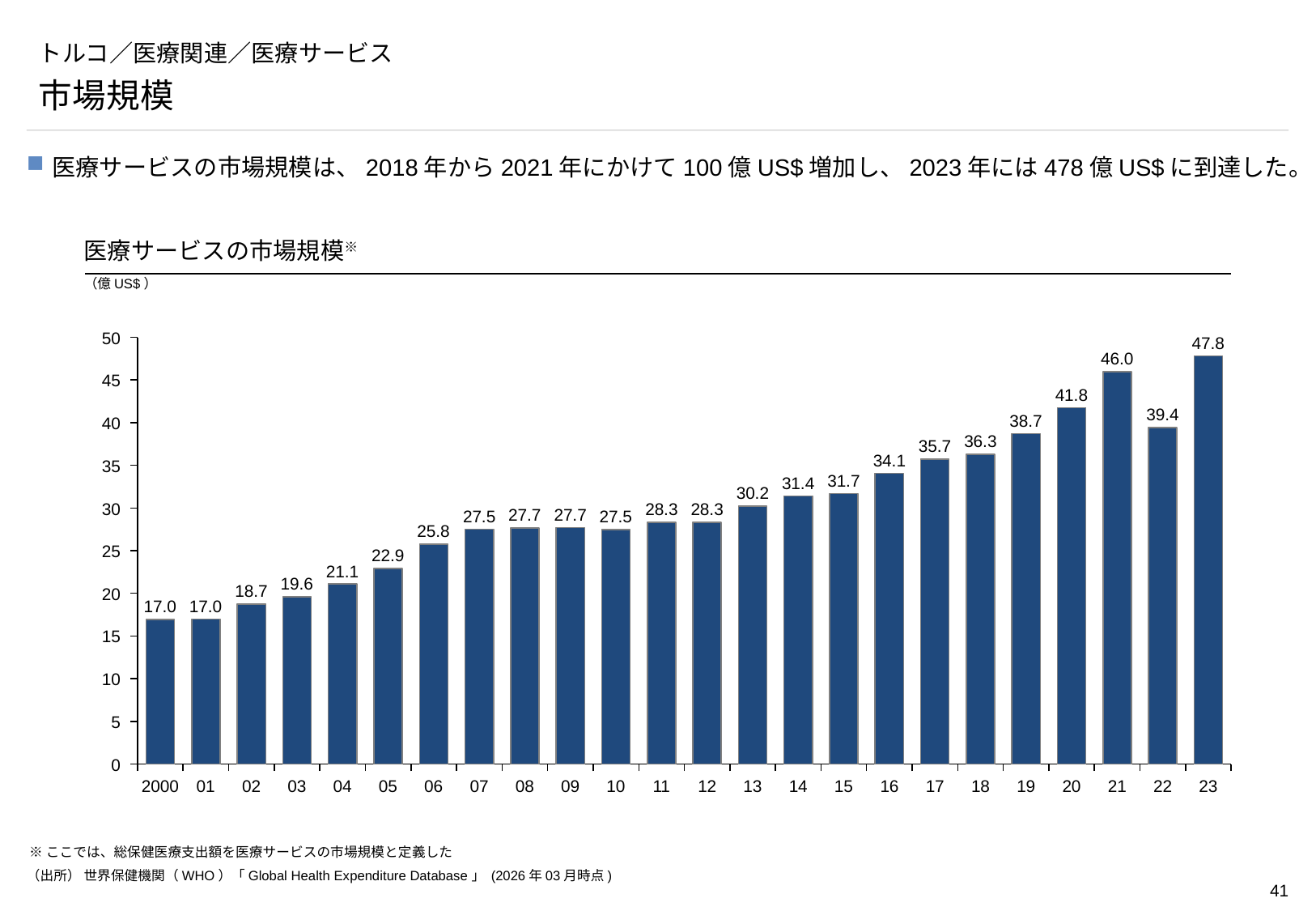
Which year has the highest value? 2023 What is the difference between the values for 2021 and 2022? 6.6 What unit is shown for the chart's values? 億 US$ Which is larger, the value for 2021 or the value for 2022? 2021 Do the values generally rise or fall from 2000 to 2023? rise What is the value for 2022? 39.4 What is the difference between the values for 2018 and 2021? 9.7 What is the value for 2010? 27.5 How many years are plotted on the chart? 24 What is the value for 2023? 47.8 What kind of chart is shown? bar chart Is the value for 2016 greater or less than 30? greater